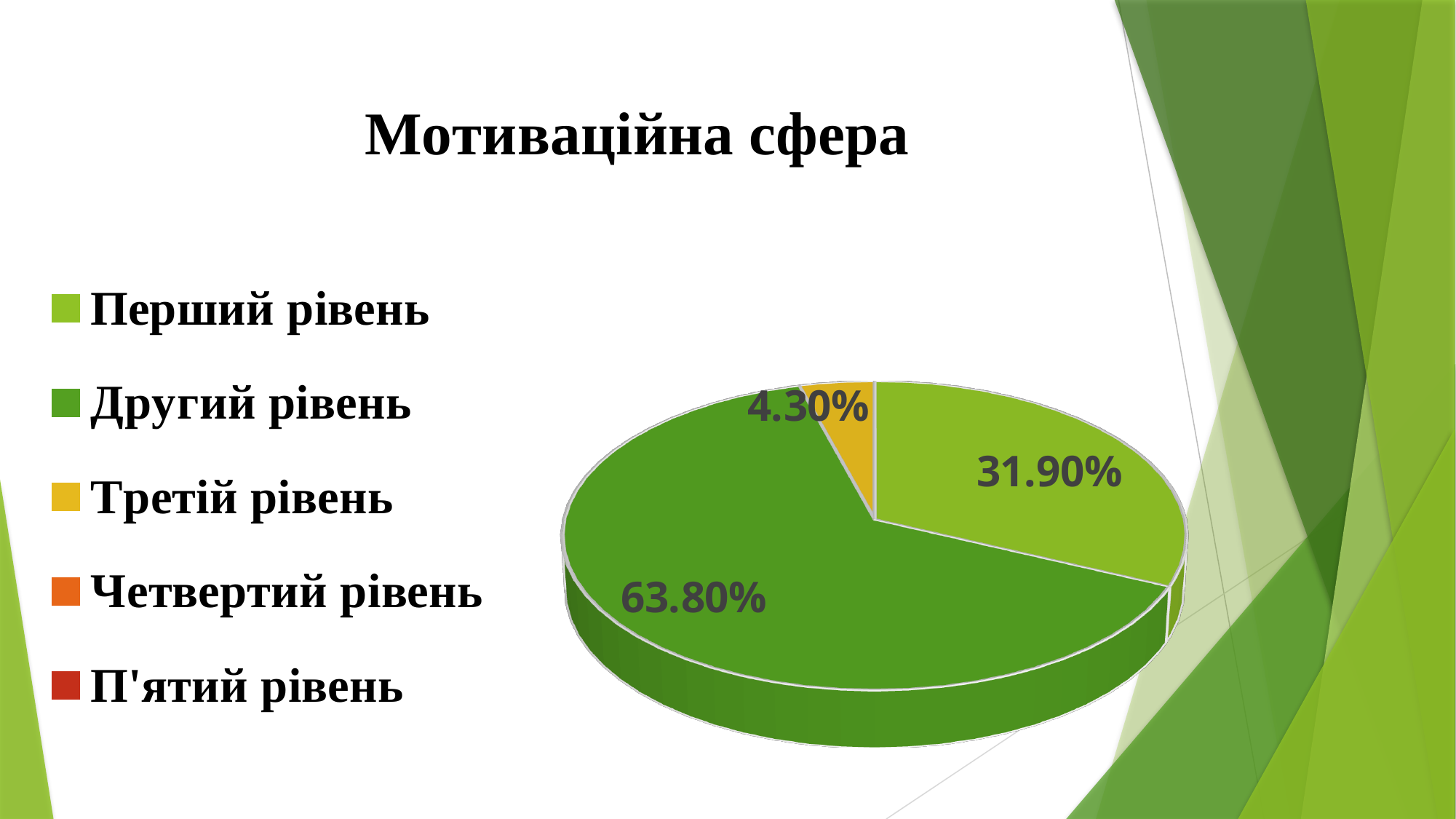
What percentage is shown for Другий рівень? 63.80% Is the value for Другий рівень greater or less than 50%? greater What is the title of the chart? Мотиваційна сфера What percentage is shown for Перший рівень? 31.90% Which category has the largest slice of the pie? Другий рівень How many slices have a percentage label printed on the pie? 3 What percentage is shown for Третій рівень? 4.30% What type of chart is shown on the slide? pie chart Of the three labelled slices, which is the smallest? Третій рівень How many entries does the legend list? 5 Which is larger, the slice for Перший рівень or the slice for Третій рівень? Перший рівень What is the difference between the percentages for Другий рівень and Перший рівень? 31.90%